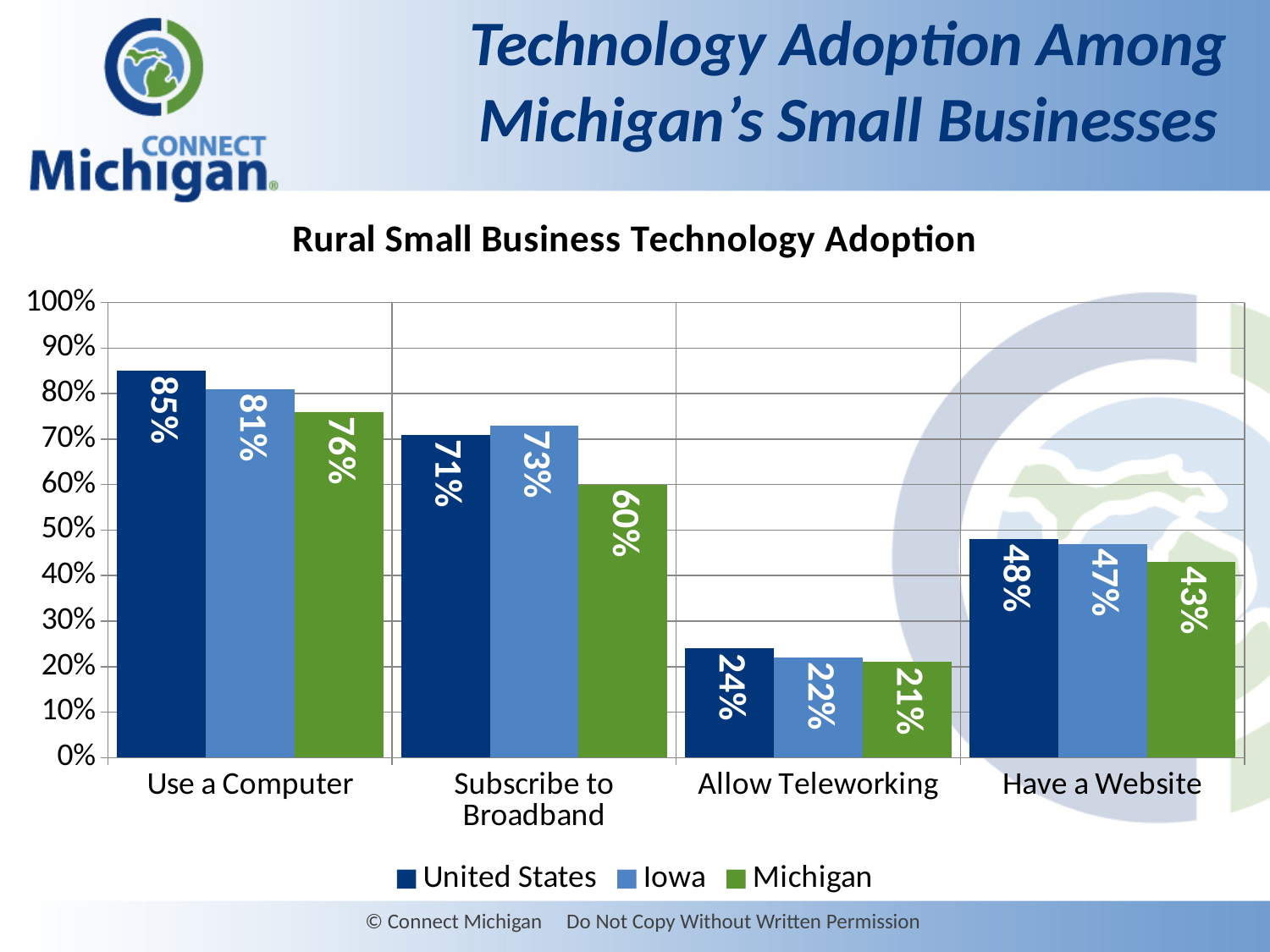
What is the title of the chart? Rural Small Business Technology Adoption Which category has the lowest value for Michigan? Allow Teleworking Which is larger in the Subscribe to Broadband category, United States or Iowa? Iowa How many categories are shown on the x axis? 4 Is the value for Michigan in the Have a Website category greater or less than 50%? less What is the difference between the United States and Michigan values for Subscribe to Broadband? 11% How many series does the legend list? 3 Which category has the highest value for United States? Use a Computer What kind of chart is shown on the slide? bar chart What is the value for Michigan in the Use a Computer category? 76% What is the value for Iowa in the Subscribe to Broadband category? 73% What is the value for United States in the Allow Teleworking category? 24%